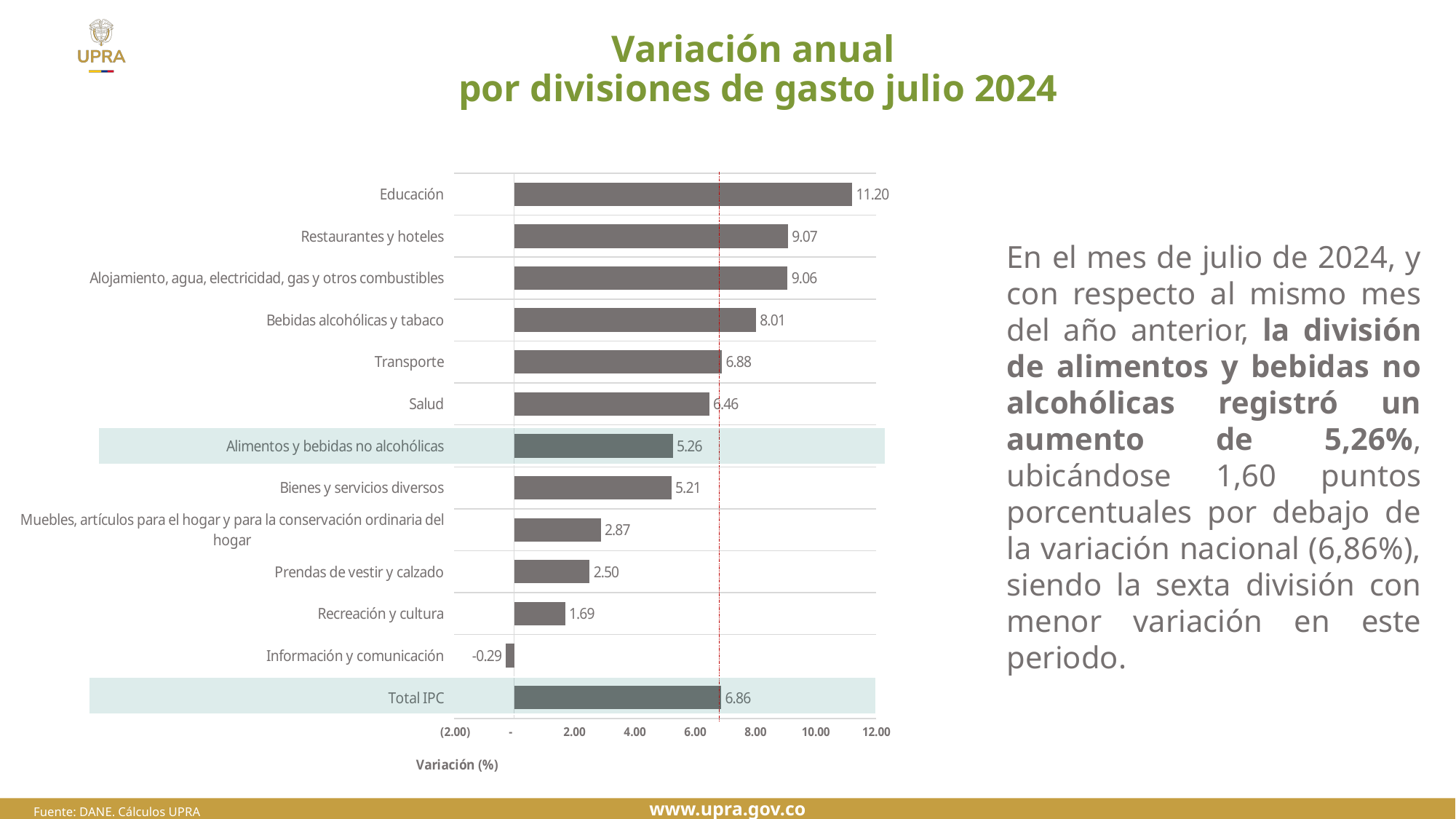
Which category has the highest value? Educación How many categories are shown in the chart? 13 What is the value for Información y comunicación? -0.29 Which is larger, the value for Transporte or the value for Salud? Transporte What is the value for Educación? 11.20 What is the value for Alimentos y bebidas no alcohólicas? 5.26 What is the difference between the values for Educación and Restaurantes y hoteles? 2.13 What is the label of the horizontal axis? Variación (%) What kind of chart is shown on the slide? Bar chart What is the value for Total IPC? 6.86 What is the difference between the values for Total IPC and Alimentos y bebidas no alcohólicas? 1.60 Which category has the lowest value? Información y comunicación